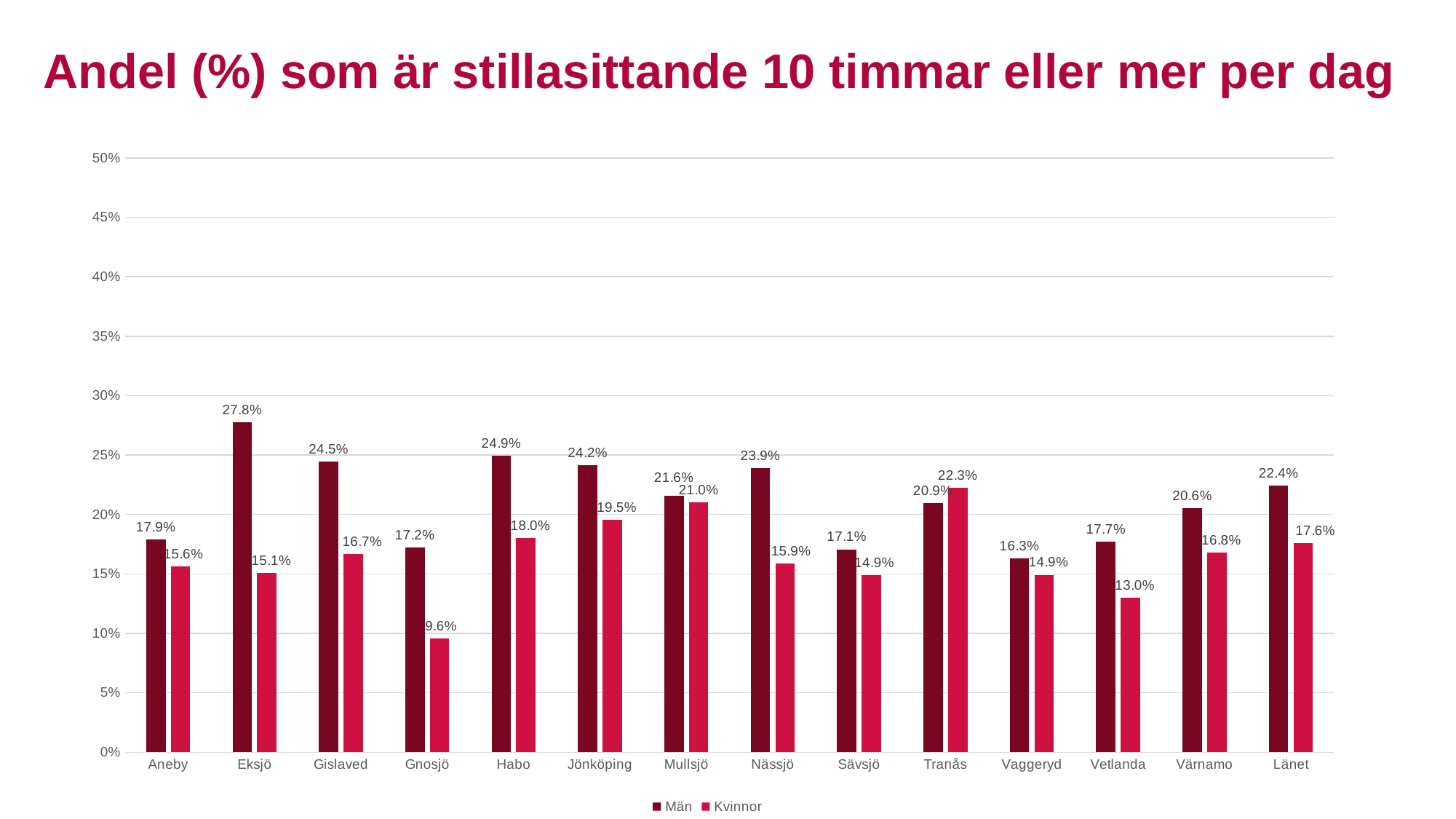
What is the difference between the Män and Kvinnor values in Eksjö? 12.7 percentage points How many categories are shown on the x axis? 14 Which category has the highest value for Män? Eksjö What kind of chart is shown on the slide? Bar chart In Tranås, which is larger: the value for Män or for Kvinnor? Kvinnor Which category has the lowest value for Kvinnor? Gnosjö What is the value for Män in Eksjö? 27.8% Which category has the highest value for Kvinnor? Tranås What is the value for Kvinnor in Länet? 17.6% What is the value for Kvinnor in Gnosjö? 9.6% Is the value for Män in Habo greater or less than 20%? greater How many series does the legend list? 2